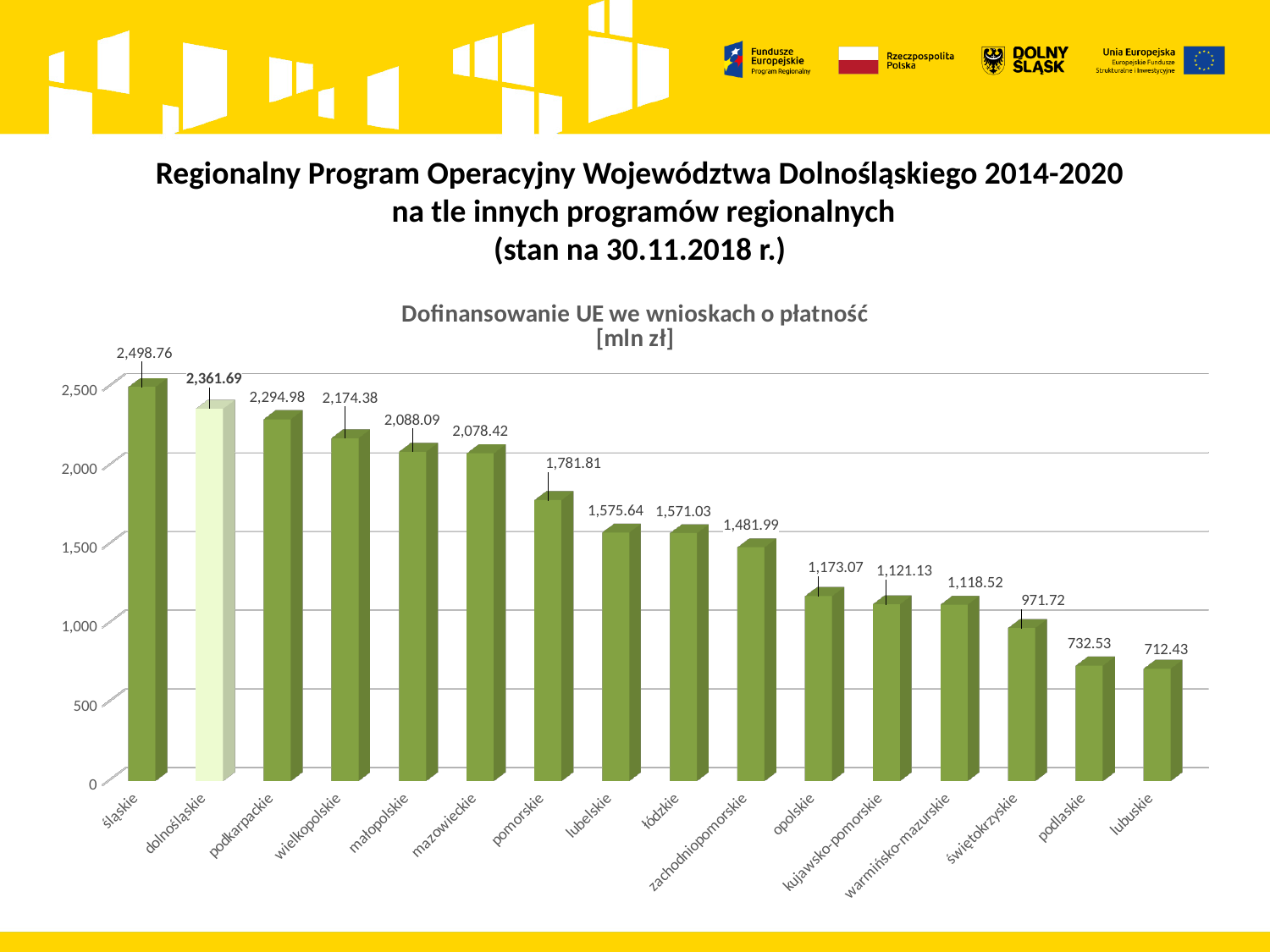
What is the difference between the values for podlaskie and lubuskie? 20.10 What kind of chart is this? bar chart How many regions are shown on the chart? 16 What is the value for pomorskie? 1,781.81 What is the title of the chart? Dofinansowanie UE we wnioskach o płatność [mln zł] Which region has the highest value? śląskie What is the difference between the values for śląskie and dolnośląskie? 137.07 Do the values rise or fall from left to right along the x axis? fall Which is larger, the value for opolskie or the value for świętokrzyskie? opolskie What is the value for dolnośląskie? 2,361.69 Which region has the lowest value? lubuskie What is the value for warmińsko-mazurskie? 1,118.52